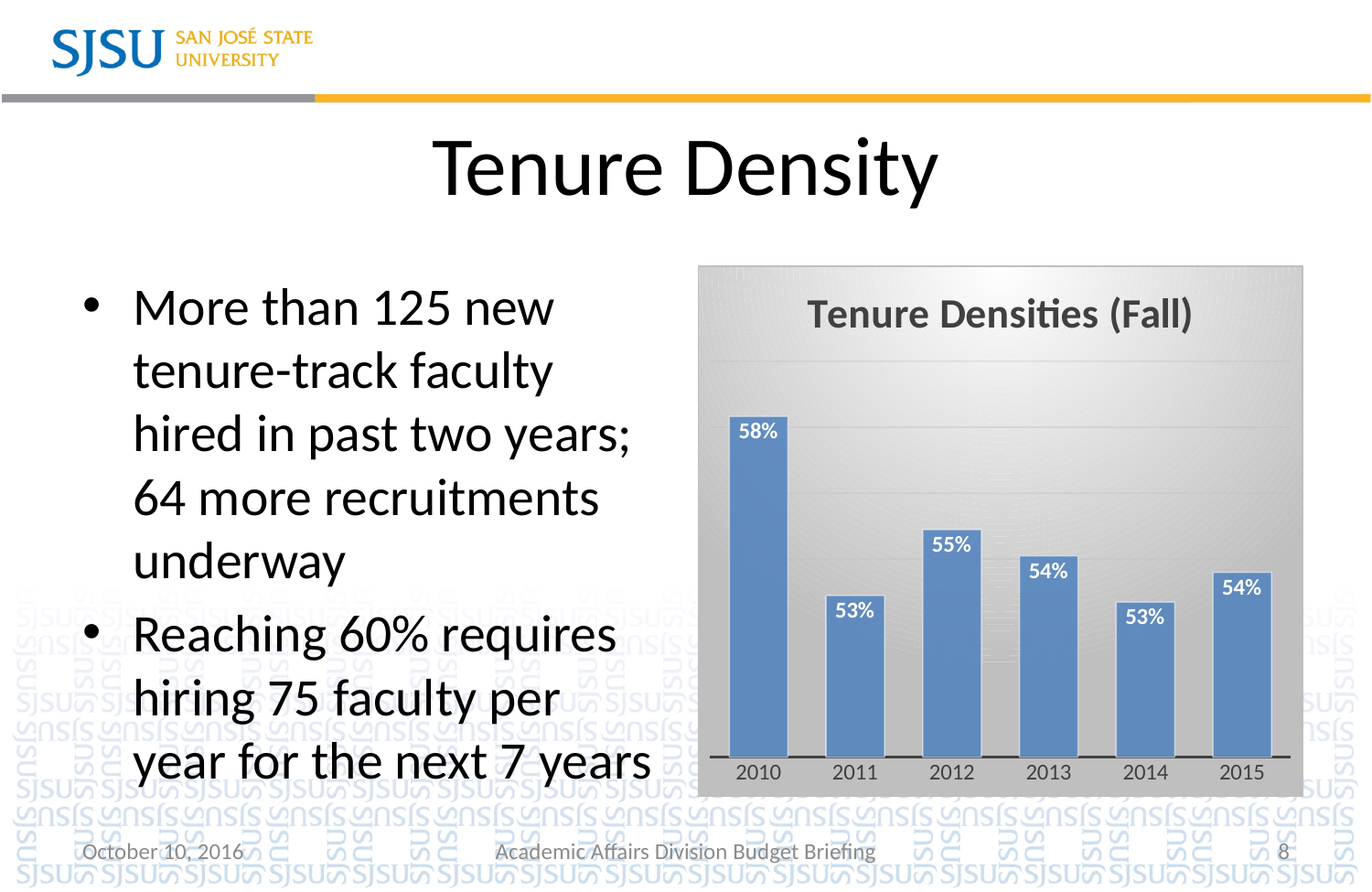
What is the tenure density shown for 2012? 55% What is the difference between the tenure density in 2010 and in 2011? 5% What is the tenure density shown for 2015? 54% What is the difference between the tenure density in 2012 and in 2014? 2% Which year has the larger tenure density, 2011 or 2015? 2015 What kind of chart is used to show the tenure densities? Bar chart Which year has the larger tenure density, 2010 or 2012? 2010 How many years are shown on the x axis of the chart? 6 Which year has the highest tenure density in the chart? 2010 What is the title of the chart on the slide? Tenure Densities (Fall) What is the tenure density shown for 2014? 53% What is the tenure density shown for 2010? 58%